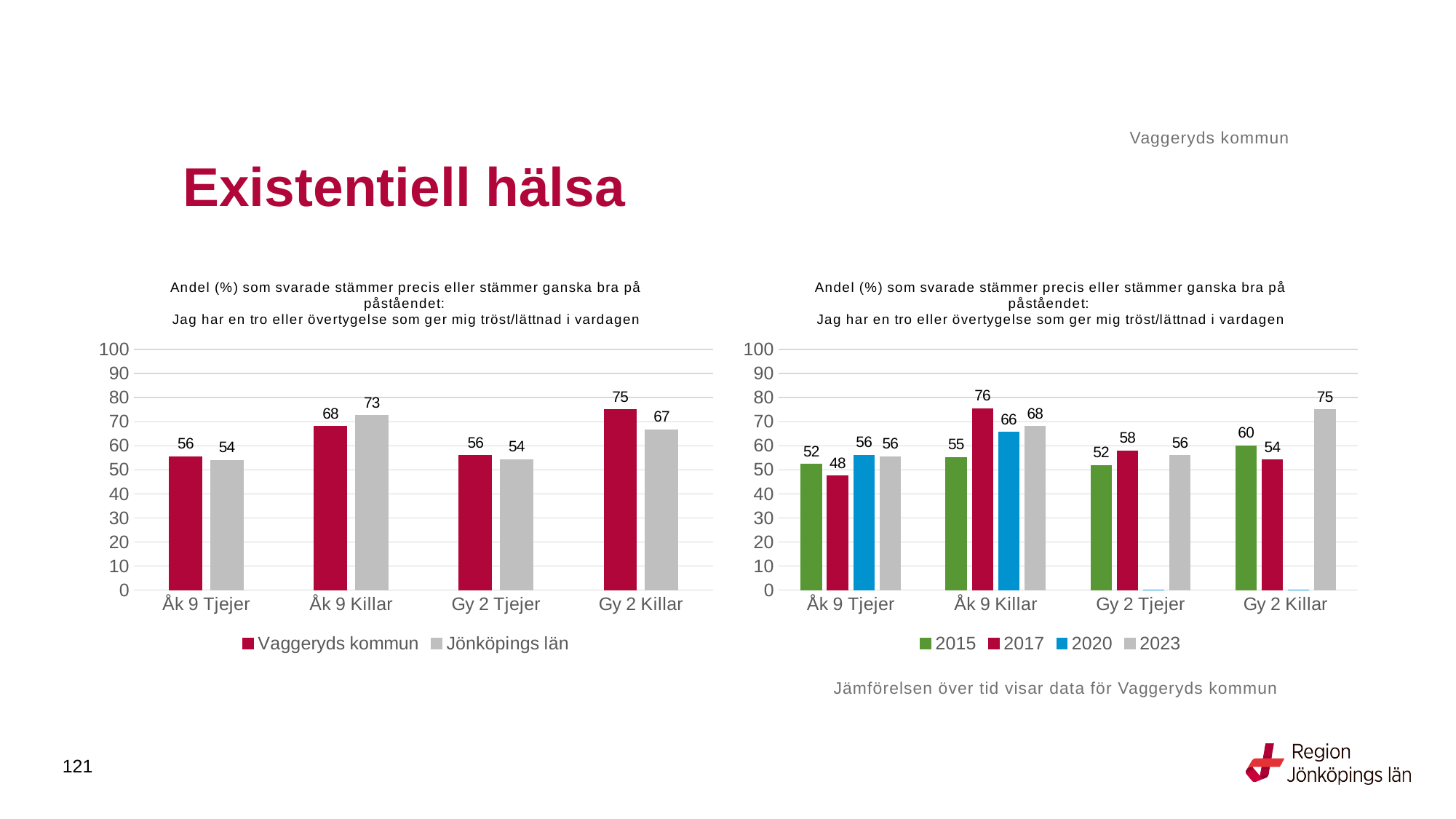
In the left chart, what is the value for Vaggeryds kommun for Åk 9 Killar? 68 In the left chart, how many series does the legend list? 2 What kind of chart is the left chart? Bar chart In the left chart, what is the value for Jönköpings län for Gy 2 Killar? 67 In the left chart, what is the difference between Jönköpings län and Vaggeryds kommun for Åk 9 Killar? 5 In the right chart, what is the value for 2017 for Åk 9 Killar? 76 In the right chart, which is larger for Gy 2 Tjejer: the 2015 value or the 2017 value? 2017 In the right chart, how many series does the legend list? 4 In the right chart, what is the value for 2015 for Gy 2 Killar? 60 In the right chart, what is the difference between the 2023 and 2015 values for Gy 2 Killar? 15 In the right chart, which category has the lowest value for 2017? Åk 9 Tjejer In the left chart, which category has the highest value for Vaggeryds kommun? Gy 2 Killar